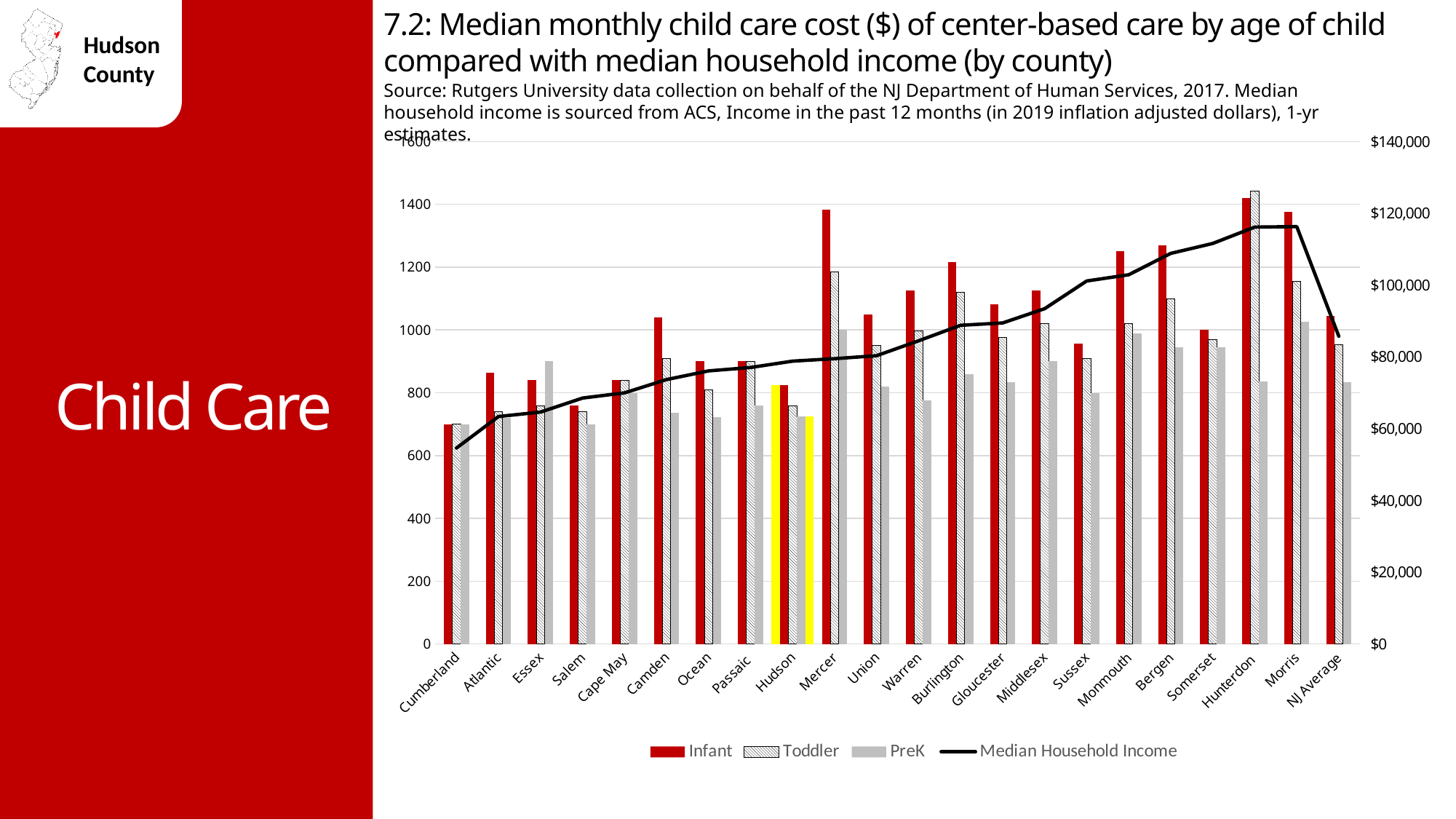
Which county's bars are highlighted in yellow? Hudson Is the Infant cost for Hudson greater or less than 1000? less Which is larger, the Infant cost for Mercer or the Infant cost for Hudson? Mercer Does the Median Household Income line generally rise or fall from Cumberland to Morris? rise Is the Median Household Income for Morris greater or less than $100,000? greater Which county has the highest Toddler cost? Hunterdon Is the Median Household Income for Cumberland greater or less than $60,000? less How many series does the legend list? 4 What kind of chart is this? bar chart with a line How many counties/categories are shown on the x axis? 22 Which county has the lowest Infant cost? Cumberland